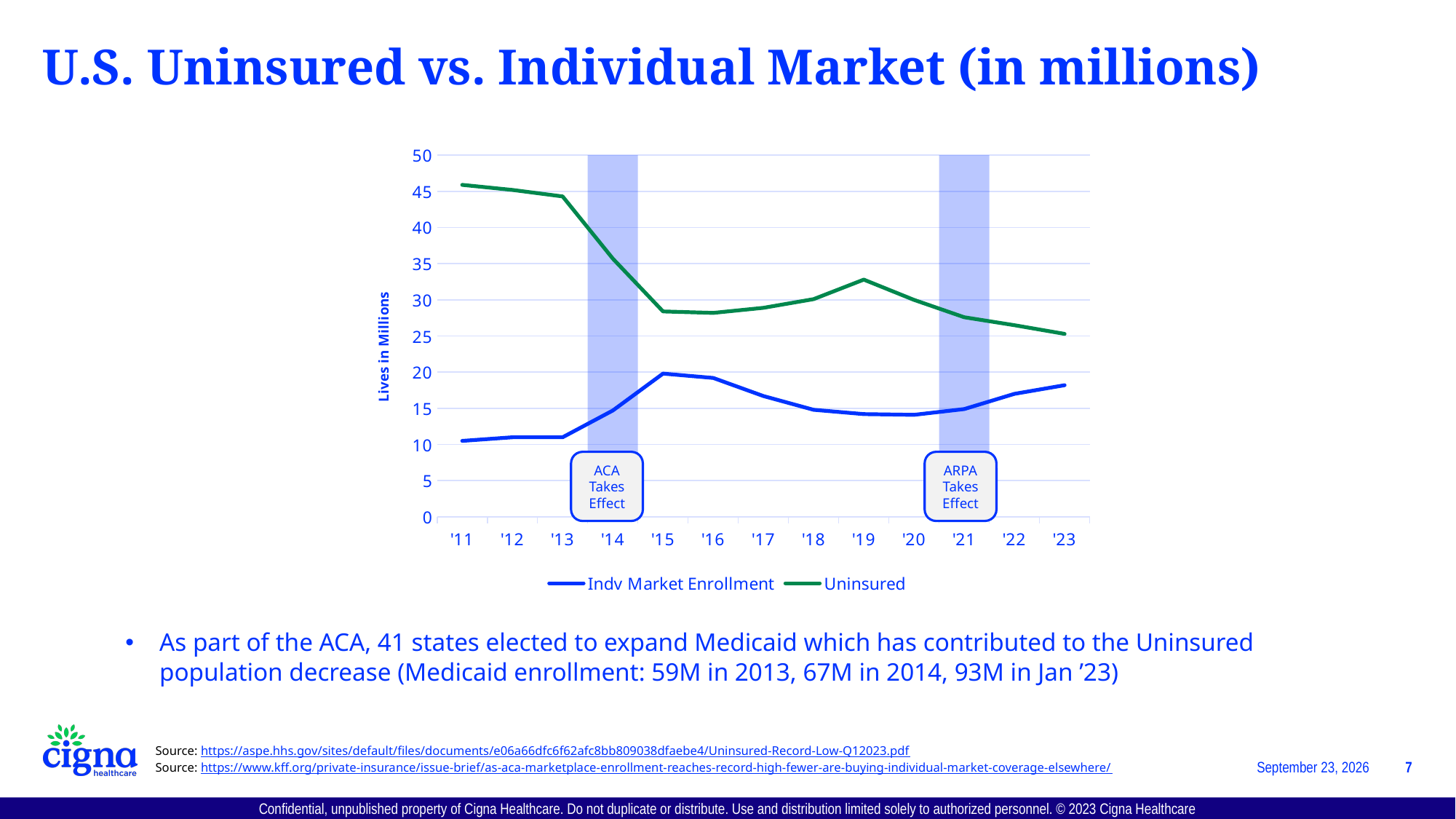
In which year is the Uninsured series at its highest? '11 Is the Uninsured value for '14 greater or less than 40? less In which year is the Uninsured series at its lowest? '23 How many years are plotted along the x axis? 13 What kind of chart is shown on the slide? line chart Is the Uninsured value for '19 greater or less than 30? greater In which year does Indv Market Enrollment reach its peak? '15 How many series does the legend list? 2 Is the Indv Market Enrollment value for '11 greater or less than 15? less What is the label on the vertical axis? Lives in Millions In '23, which series has the larger value, Indv Market Enrollment or Uninsured? Uninsured Does the Uninsured series rise or fall from '11 to '15? fall